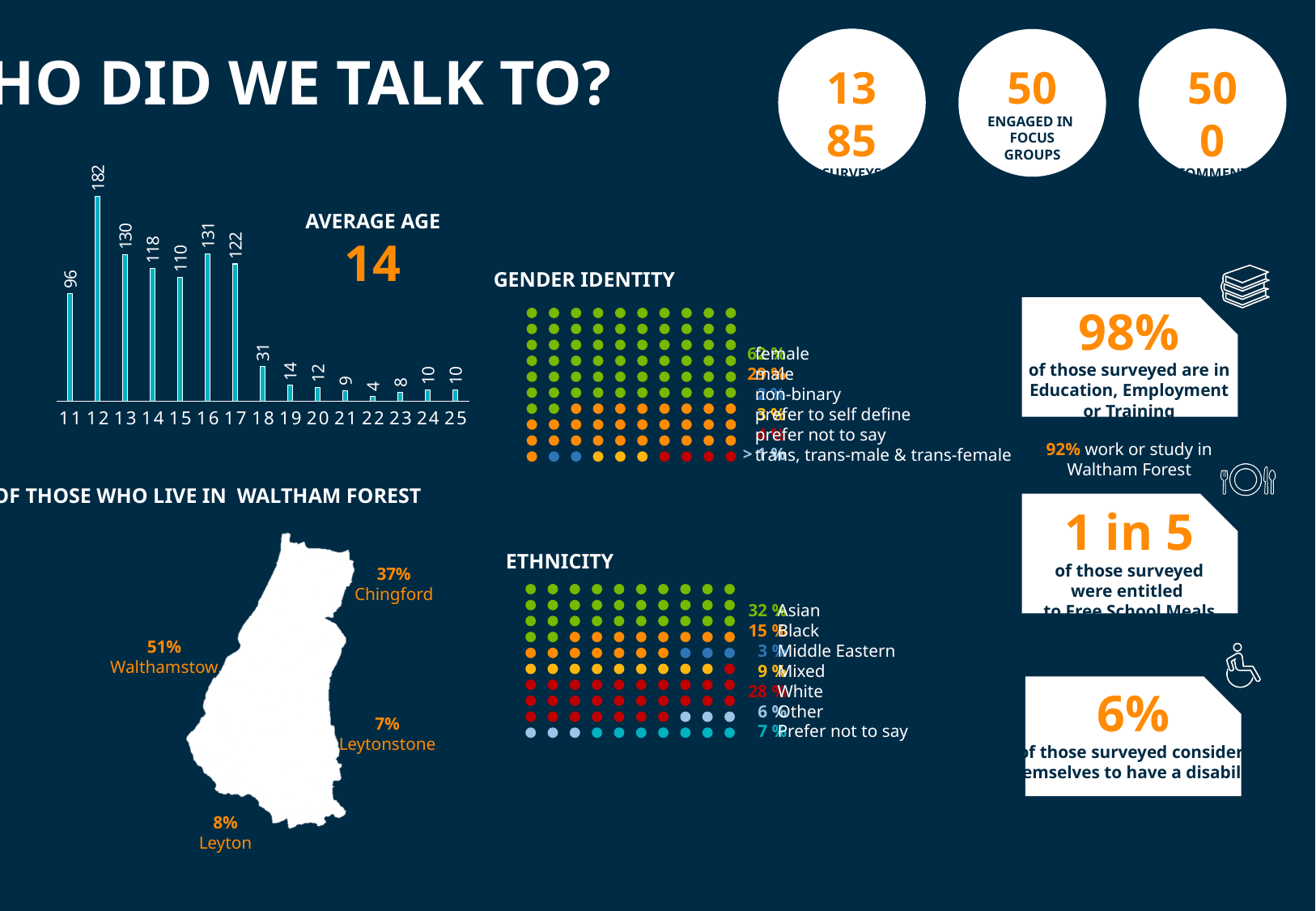
What kind of chart is used to show the number of respondents by age? bar chart In the age bar chart, which is larger, the value for age 14 or the value for age 17? age 17 In the age bar chart, which age has the lowest number of respondents? 22 How many age categories are shown on the x axis of the age bar chart? 15 In the ethnicity dot chart, what percentage of respondents are Asian? 32% In the age bar chart, how many respondents were aged 16? 131 In the age bar chart, do the values generally rise or fall from age 17 to age 22? fall In the ethnicity dot chart, what percentage of respondents are White? 28% In the age bar chart, what is the difference between the values for age 12 and age 13? 52 In the age bar chart, what is the value for age 18? 31 In the age bar chart, which age has the highest number of respondents? 12 In the age bar chart, how many respondents were aged 12? 182